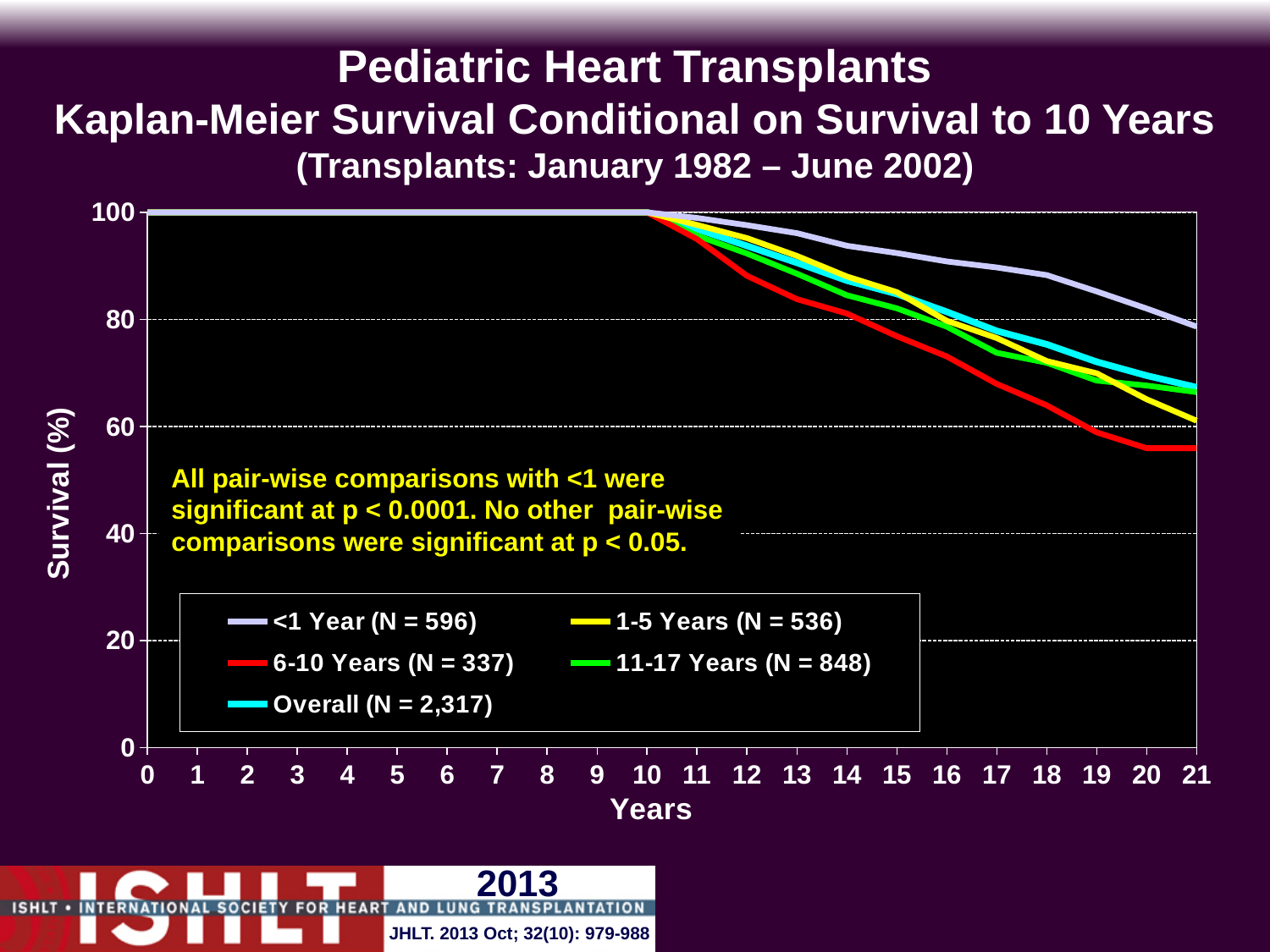
Is the survival for the Overall series at 21 years greater or less than 60? greater What kind of chart is shown on the slide? line chart Which series has the lowest survival at 21 years? 6-10 Years What is the N for the Overall series shown in the legend? 2,317 What is the label of the y axis? Survival (%) Do the survival curves rise or fall after year 10? fall Is the survival for the 6-10 Years series at 15 years greater or less than 80? less How many series does the legend list? 5 Which is higher at 21 years, the <1 Year series or the 6-10 Years series? <1 Year Is the survival for the <1 Year series at 15 years greater or less than 80? greater Which series has the highest survival at 21 years? <1 Year